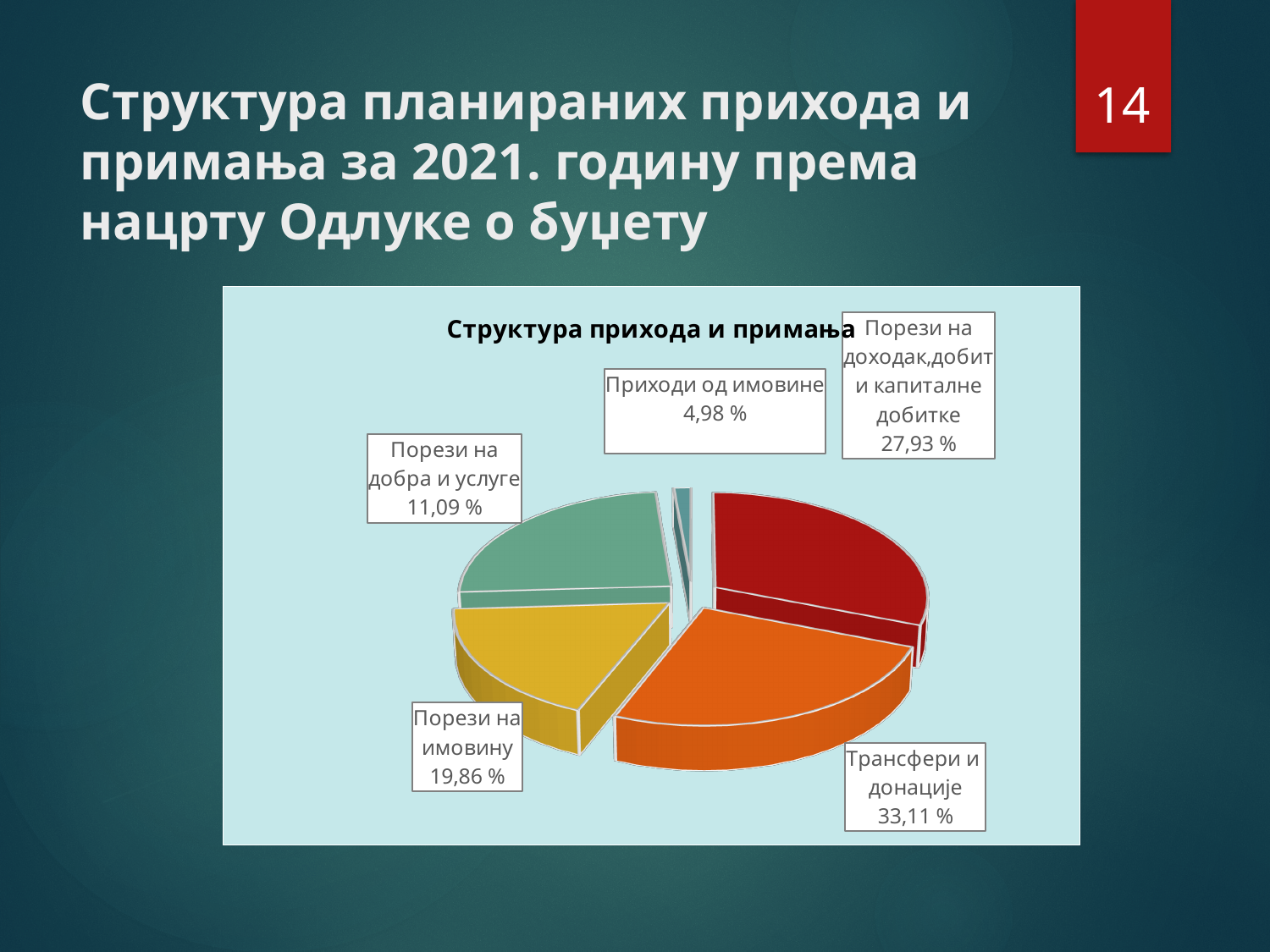
What share of the pie is labelled for Приходи од имовине? 4,98 % Which labelled category has the largest share of the pie? Трансфери и донације What is the difference in percentage points between the share for Трансфери и донације and the share for Порези на доходак,добит и капиталне добитке? 5,18 Which labelled category has the smallest share of the pie? Приходи од имовине What is the title of the chart? Структура прихода и примања What share of the pie is labelled for Порези на доходак,добит и капиталне добитке? 27,93 % What share of the pie is labelled for Порези на добра и услуге? 11,09 % What share of the pie is labelled for Трансфери и донације? 33,11 % Which is larger: the share for Порези на имовину or the share for Порези на добра и услуге? Порези на имовину What kind of chart is shown on the slide? pie chart What share of the pie is labelled for Порези на имовину? 19,86 % What is the difference in percentage points between the share for Порези на имовину and the share for Приходи од имовине? 14,88